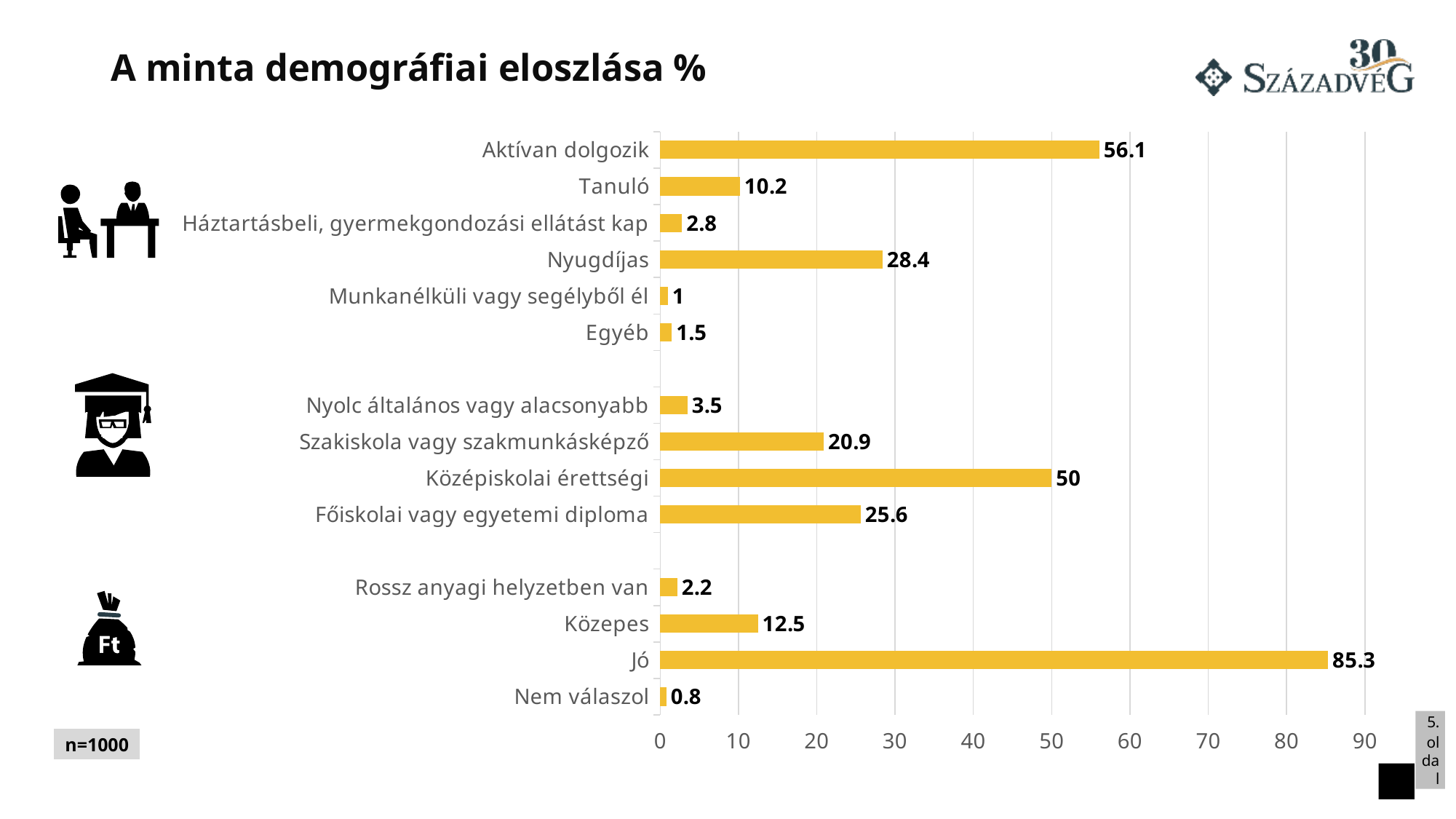
Is the value for Főiskolai vagy egyetemi diploma greater or less than 20? greater What is the value for Középiskolai érettségi? 50 What is the value for Aktívan dolgozik? 56.1 How many categories are plotted on the chart? 14 Which is larger, the value for Tanuló or the value for Közepes? Közepes What is the title of the chart? A minta demográfiai eloszlása % What is the difference between the values for Jó and Közepes? 72.8 What is the value for Nem válaszol? 0.8 Which category has the highest value on the chart? Jó What is the value for Nyugdíjas? 28.4 Which category has the lowest value on the chart? Nem válaszol What kind of chart is shown on the slide? bar chart